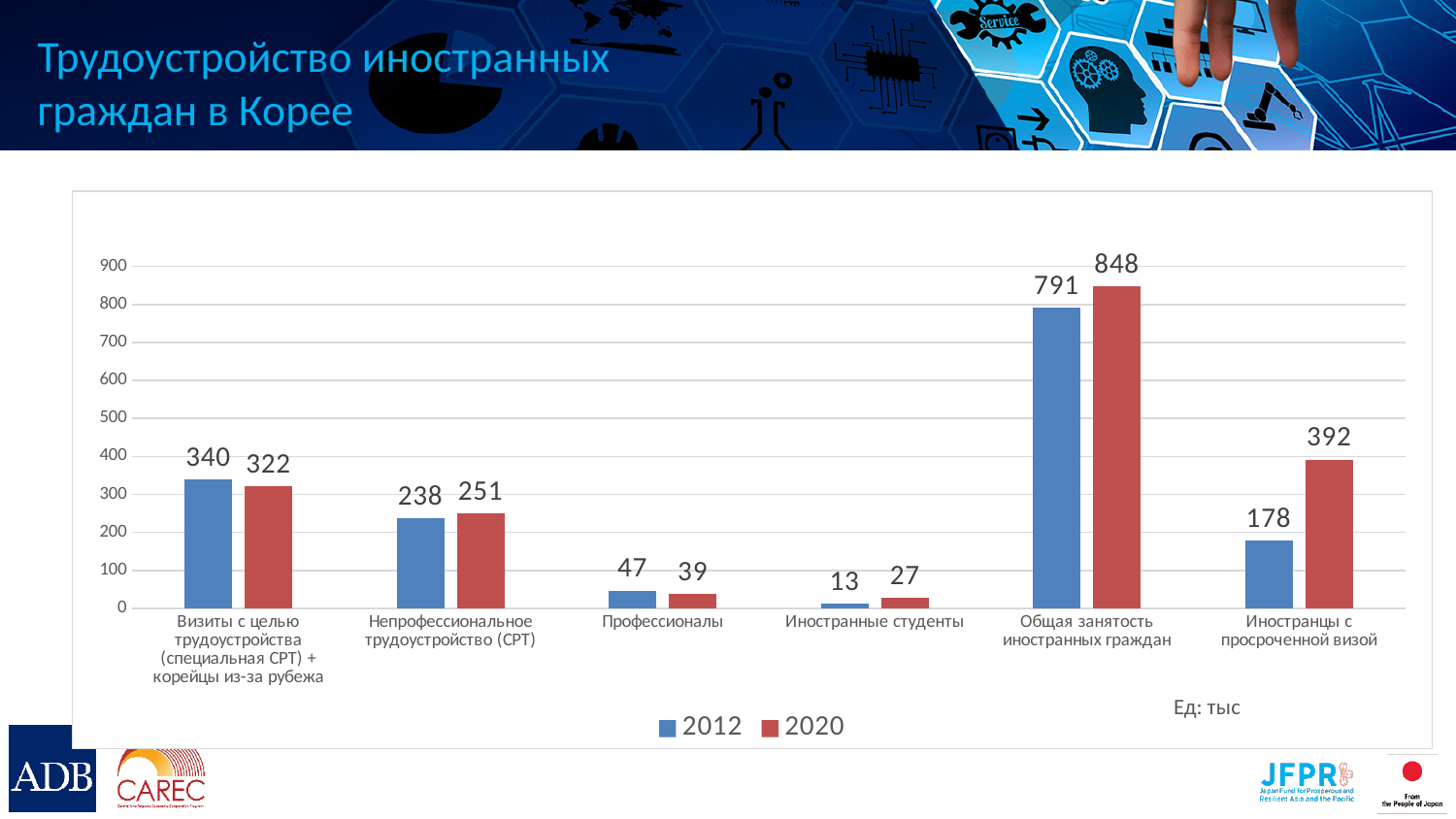
What type of chart is shown on the slide? Bar chart How many series does the legend list? 2 For Визиты с целью трудоустройства (специальная СРТ) + корейцы из-за рубежа, which year has the larger value, 2012 or 2020? 2012 What is the 2012 value for Профессионалы? 47 What is the 2020 value for Иностранцы с просроченной визой? 392 Which category has the highest 2020 value? Общая занятость иностранных граждан What is the difference between the 2020 and 2012 values for Иностранцы с просроченной визой? 214 What is the 2020 value for Иностранные студенты? 27 For Непрофессиональное трудоустройство (СРТ), which year has the larger value, 2012 or 2020? 2020 How many categories are shown on the x axis? 6 What is the difference between the 2020 and 2012 values for Общая занятость иностранных граждан? 57 Which category has the lowest 2012 value? Иностранные студенты